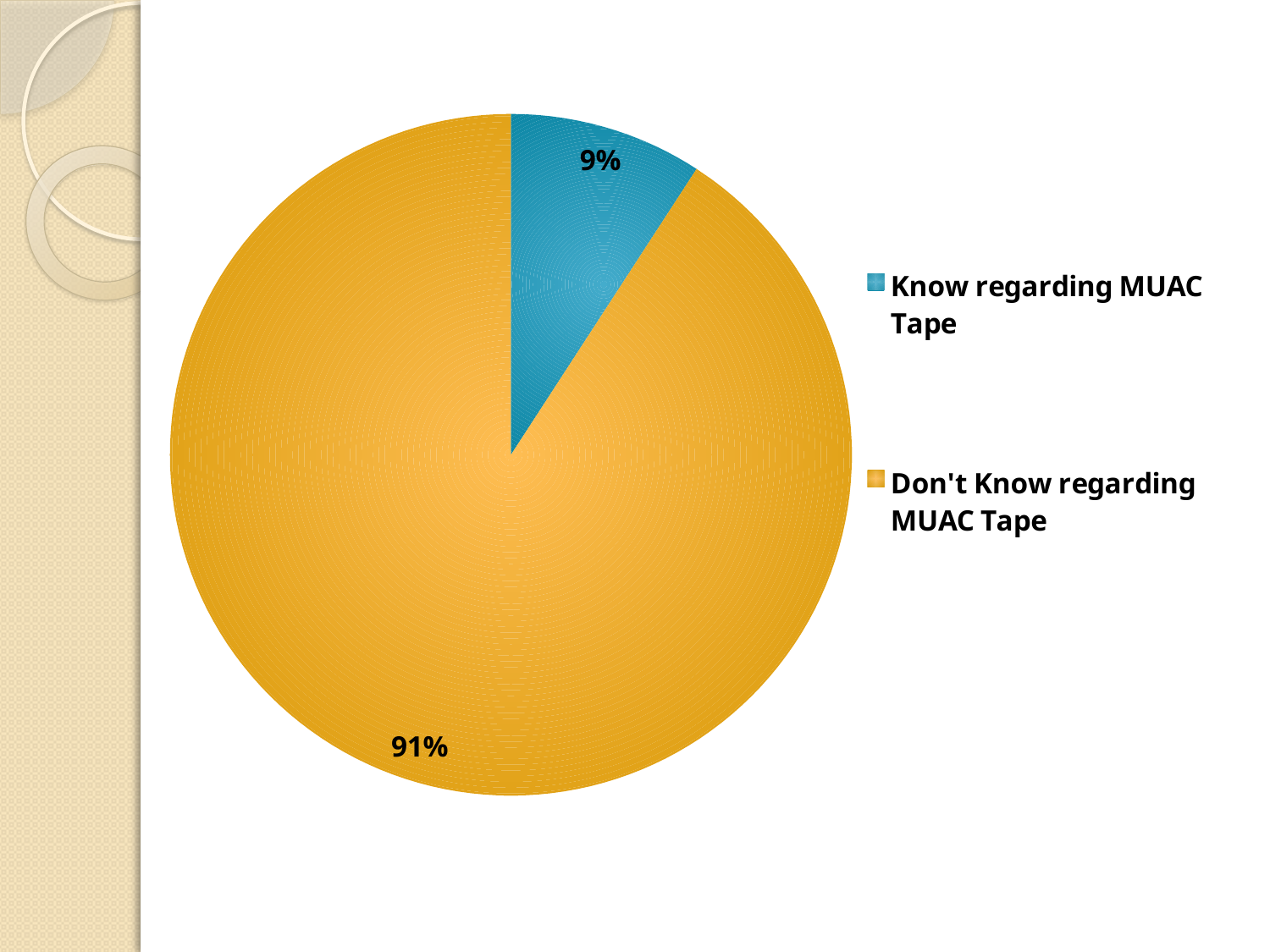
What colour is the "Know regarding MUAC Tape" slice? blue What kind of chart is shown on the slide? pie chart What share of the pie is labelled "Know regarding MUAC Tape"? 9% How many slices does the pie chart have? 2 How many entries does the legend list? 2 What colour is the "Don't Know regarding MUAC Tape" slice? orange Which is larger: the "Know regarding MUAC Tape" slice or the "Don't Know regarding MUAC Tape" slice? Don't Know regarding MUAC Tape What is the difference in percentage points between the "Don't Know regarding MUAC Tape" slice and the "Know regarding MUAC Tape" slice? 82 Which slice of the pie is the largest? Don't Know regarding MUAC Tape What share of the pie is labelled "Don't Know regarding MUAC Tape"? 91% Which slice of the pie is the smallest? Know regarding MUAC Tape